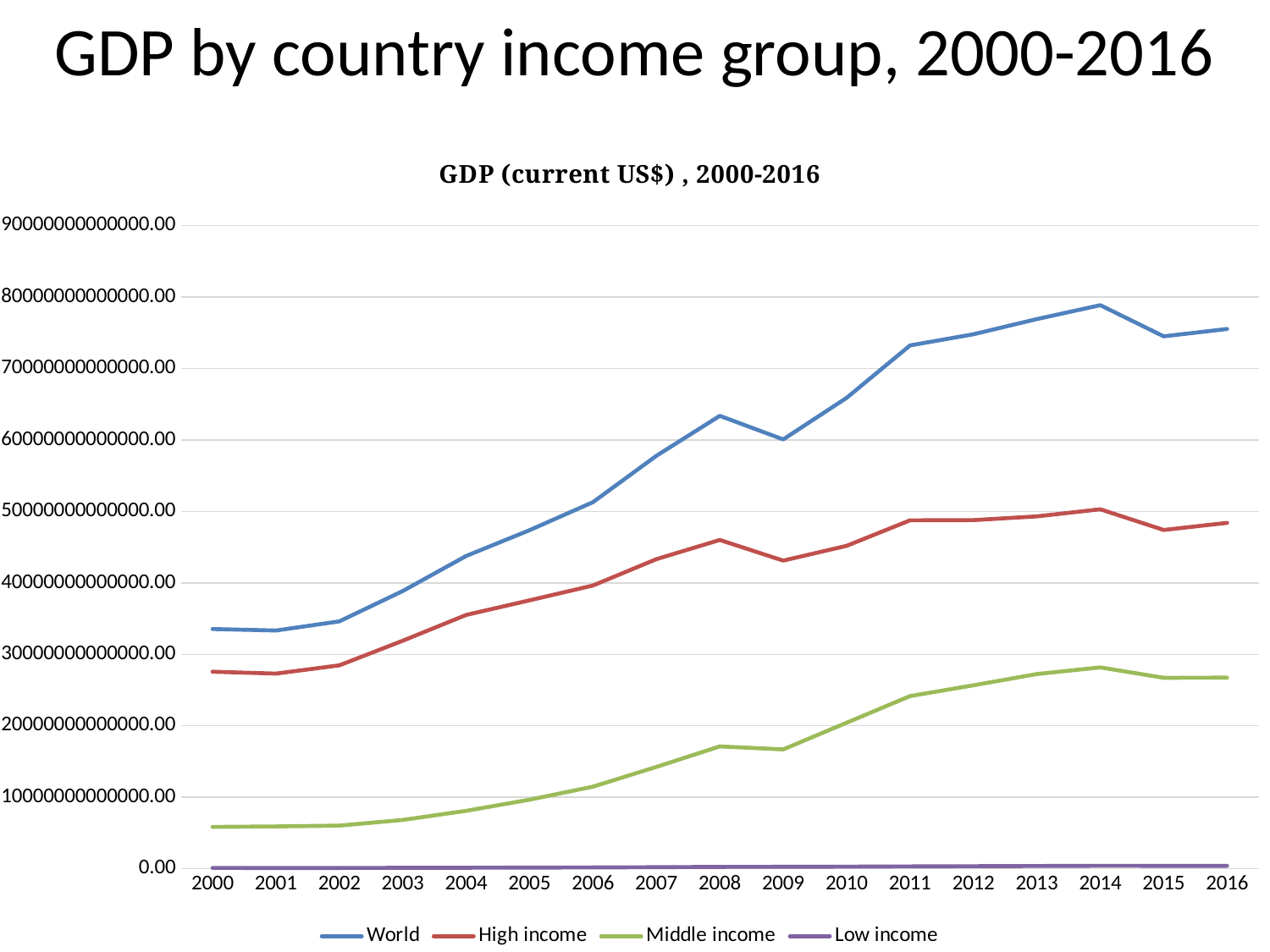
Is the value for Middle income in 2008 greater or less than 200000000000000.00? less Which series has the lowest values across all years? Low income What is the title printed above the chart? GDP (current US$) , 2000-2016 In which year does the World series reach its highest value? 2014 Which series are listed in the legend? World, High income, Middle income, Low income What kind of chart is shown on the slide? line chart In which year does the High income series reach its highest value? 2014 Is the value for World in 2016 greater or less than 700000000000000.00? greater Which is larger for the High income series, the value in 2008 or the value in 2009? 2008 Does the Middle income series generally rise or fall from 2000 to 2014? rise How many years are plotted along the x axis? 17 How many series does the legend list? 4